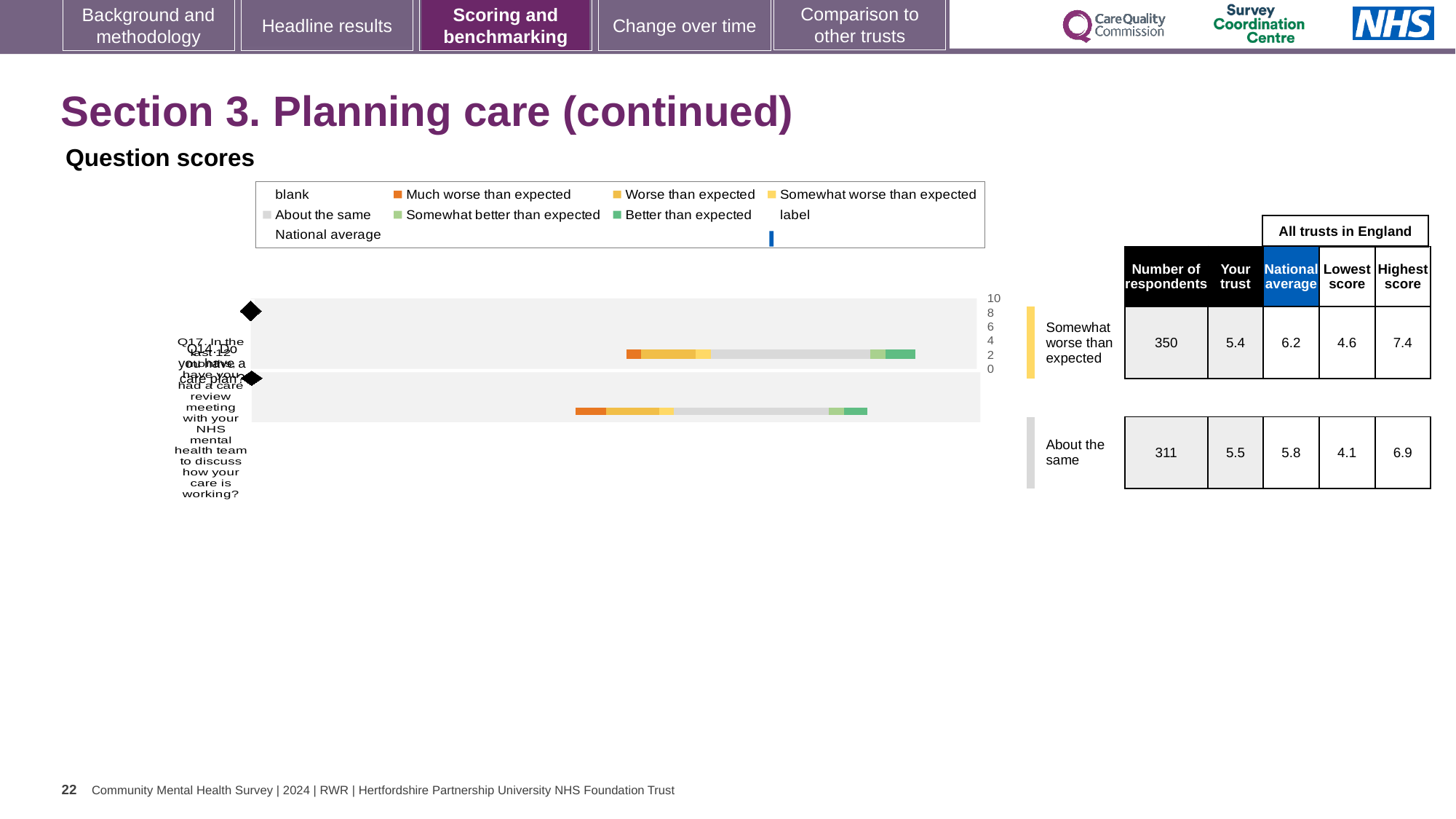
How many question rows are plotted in the chart? 2 For the row rated 'About the same', what is the difference between the highest score and the lowest score? 2.8 In the table beside the chart, what is the number of respondents for the row rated 'Somewhat worse than expected'? 350 In the table beside the chart, what is the lowest score for the row rated 'Somewhat worse than expected'? 4.6 In the table beside the chart, what is the national average for the row rated 'Somewhat worse than expected'? 6.2 In the table beside the chart, what is the highest score for the row rated 'About the same'? 6.9 What kind of chart is shown under 'Question scores'? bar chart What colour does the legend use for 'Much worse than expected'? Orange In the table beside the chart, what is the 'Your trust' score for the row rated 'About the same'? 5.5 For the row rated 'Somewhat worse than expected', how much higher is the national average than the 'Your trust' score? 0.8 For the row rated 'About the same', which is larger: the 'Your trust' score or the national average? National average Which row has more respondents, 'Somewhat worse than expected' or 'About the same'? Somewhat worse than expected